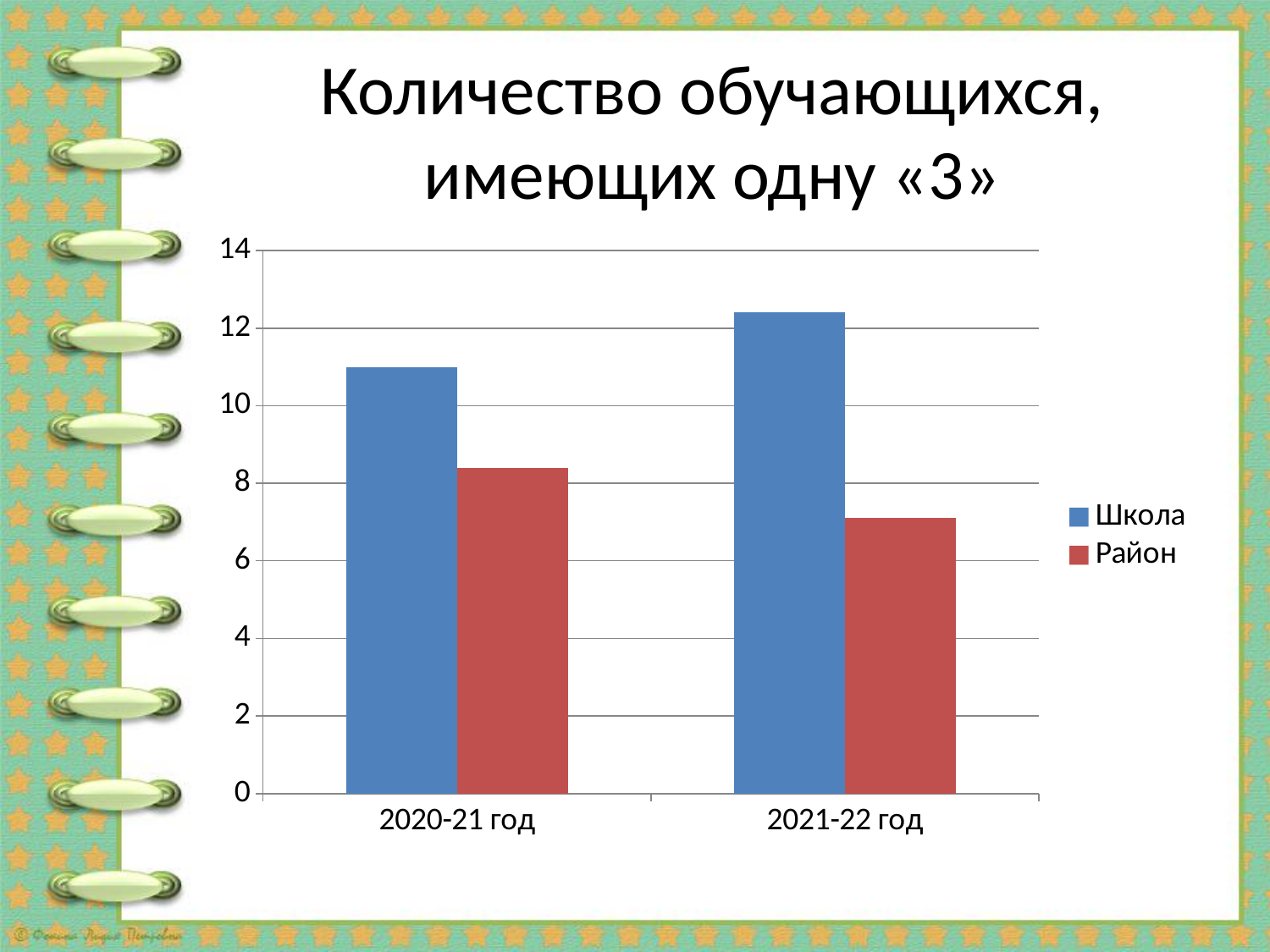
Does the value for Школа rise or fall from 2020-21 год to 2021-22 год? rise Which is larger in 2020-21 год, Школа or Район? Школа Does the value for Район rise or fall from 2020-21 год to 2021-22 год? fall What kind of chart is shown on the slide? bar chart How many series does the legend list? 2 How many categories are shown on the x axis? 2 Which is larger in 2021-22 год, Школа or Район? Школа Is the value for Школа in 2020-21 год greater or less than 10? greater Is the value for Район in 2020-21 год greater or less than 10? less What is the title of the chart? Количество обучающихся, имеющих одну «3» Is the value for Район in 2021-22 год greater or less than 8? less